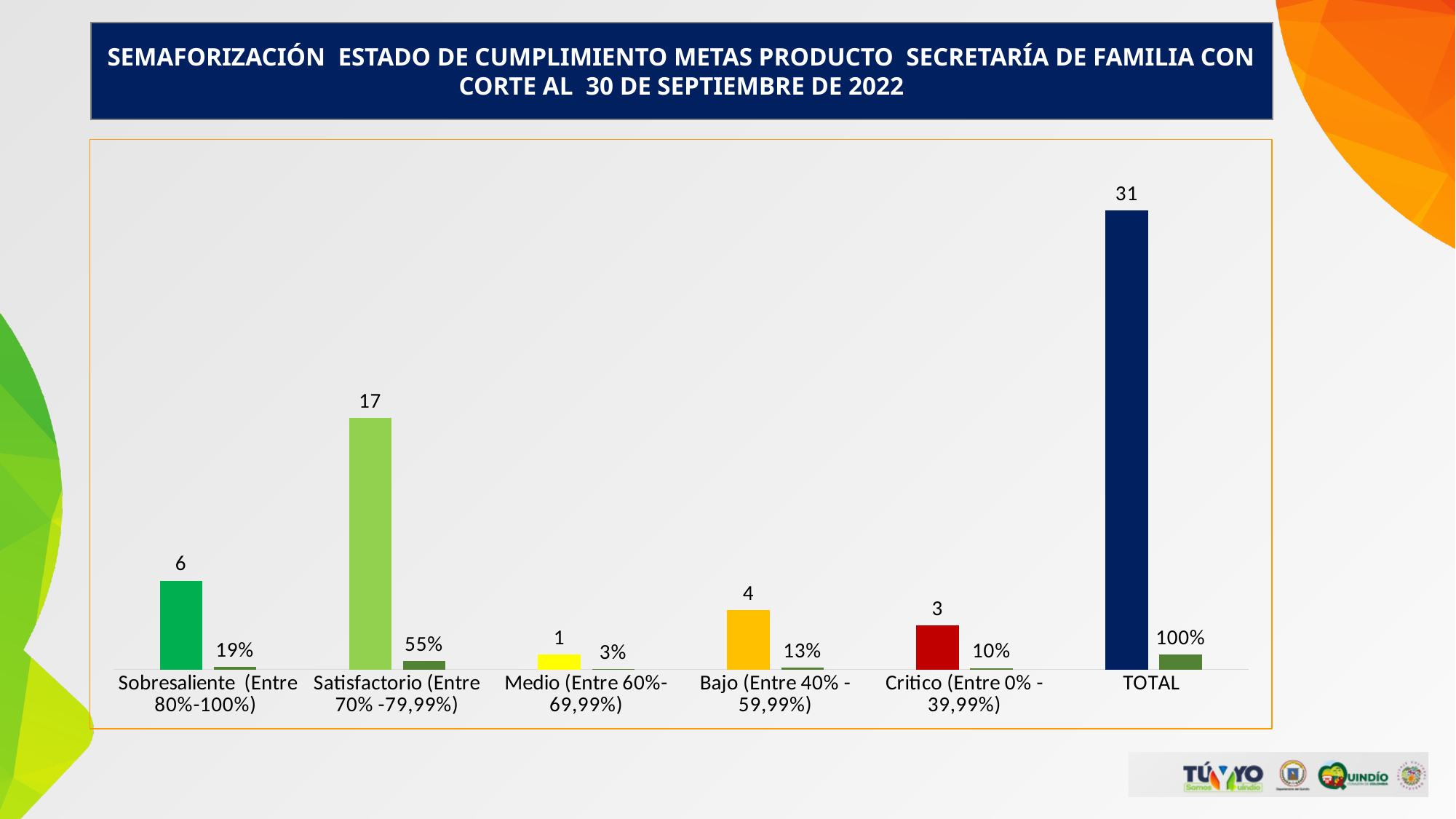
What is the count value shown for the Satisfactorio (Entre 70% -79,99%) category? 17 Which has a larger count, Bajo (Entre 40% - 59,99%) or Critico (Entre 0% - 39,99%)? Bajo (Entre 40% - 59,99%) What is the difference between the counts for Satisfactorio (Entre 70% -79,99%) and Sobresaliente (Entre 80%-100%)? 11 Which category has the lowest count? Medio (Entre 60%-69,99%) What percentage is shown for the Sobresaliente (Entre 80%-100%) category? 19% What kind of chart is shown on the slide? Bar chart What is the count value shown for the Critico (Entre 0% - 39,99%) category? 3 Excluding TOTAL, which category has the highest count? Satisfactorio (Entre 70% -79,99%) How many categories are shown on the x axis of the chart? 6 What percentage is shown for the Bajo (Entre 40% - 59,99%) category? 13% What is the count value shown for the TOTAL category? 31 What colour is the bar for the Critico (Entre 0% - 39,99%) category? Red